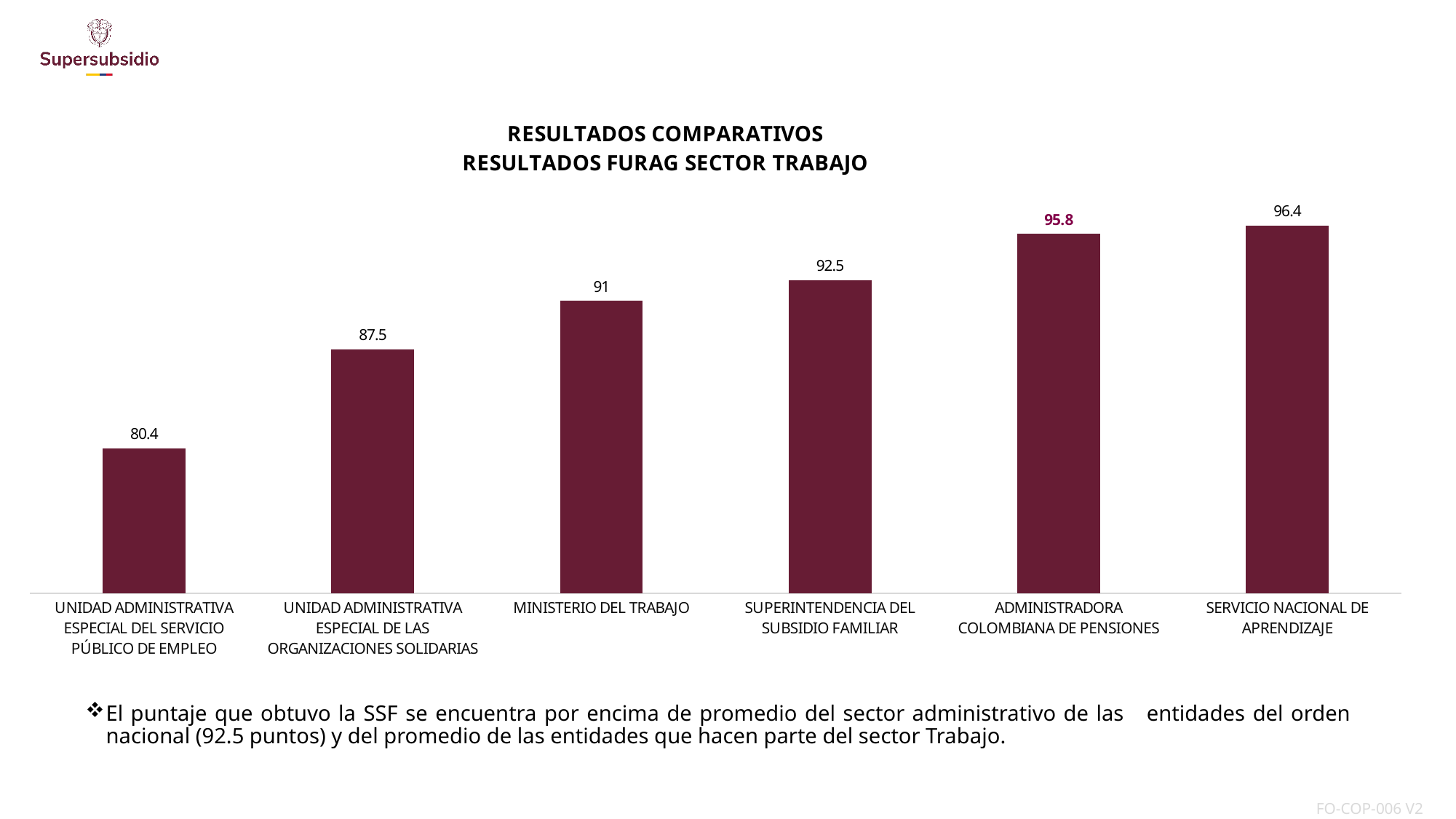
Which category has the lowest value? UNIDAD ADMINISTRATIVA ESPECIAL DEL SERVICIO PÚBLICO DE EMPLEO What is the value for UNIDAD ADMINISTRATIVA ESPECIAL DEL SERVICIO PÚBLICO DE EMPLEO? 80.4 What kind of chart is shown on the slide? Bar chart What is the value for MINISTERIO DEL TRABAJO? 91 What is the difference between the values for SERVICIO NACIONAL DE APRENDIZAJE and UNIDAD ADMINISTRATIVA ESPECIAL DEL SERVICIO PÚBLICO DE EMPLEO? 16 What is the value for SUPERINTENDENCIA DEL SUBSIDIO FAMILIAR? 92.5 Do the values rise or fall from left to right across the categories? Rise What is the value for ADMINISTRADORA COLOMBIANA DE PENSIONES? 95.8 How many categories are shown in the chart? 6 Which is larger, the value for MINISTERIO DEL TRABAJO or the value for UNIDAD ADMINISTRATIVA ESPECIAL DE LAS ORGANIZACIONES SOLIDARIAS? MINISTERIO DEL TRABAJO What is the difference between the values for ADMINISTRADORA COLOMBIANA DE PENSIONES and SUPERINTENDENCIA DEL SUBSIDIO FAMILIAR? 3.3 Which category has the highest value? SERVICIO NACIONAL DE APRENDIZAJE